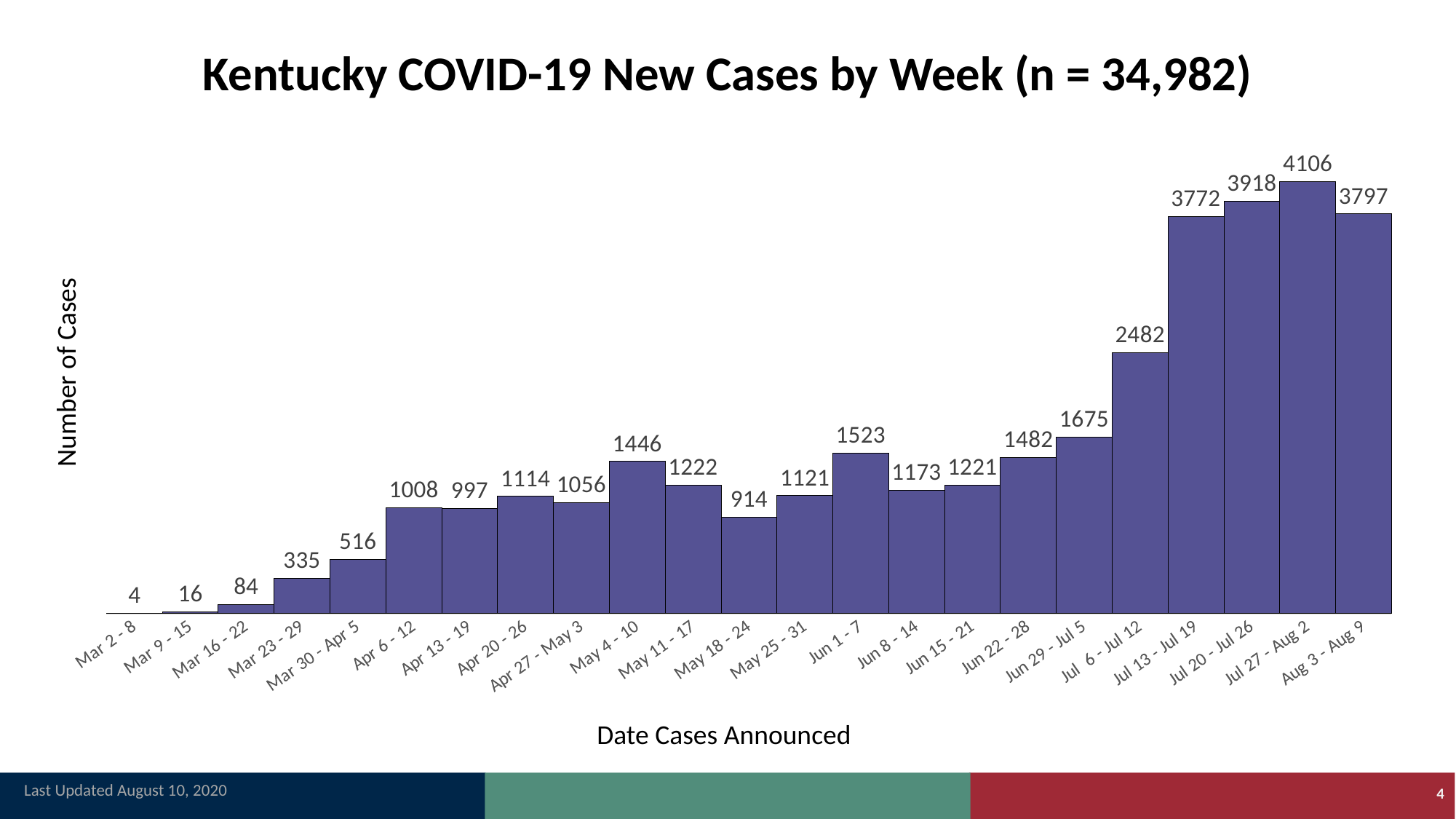
How many weeks are shown on the x axis? 23 Do the values generally rise or fall from Jun 29 - Jul 5 through Jul 27 - Aug 2? Rise What is the value for the week Jul 6 - Jul 12? 2482 What kind of chart is shown on the slide? Bar chart What is the title of the chart? Kentucky COVID-19 New Cases by Week (n = 34,982) What is the number of new cases for the week Jul 27 - Aug 2? 4106 Which week has the lowest number of new cases? Mar 2 - 8 Which week had more new cases, Jun 1 - 7 or Jun 22 - 28? Jun 1 - 7 Which week has the highest number of new cases? Jul 27 - Aug 2 How many new cases were announced in the week May 18 - 24? 914 What is the difference in new cases between the weeks Jul 13 - Jul 19 and Jul 6 - Jul 12? 1290 What is the difference in new cases between the weeks Jul 27 - Aug 2 and Aug 3 - Aug 9? 309